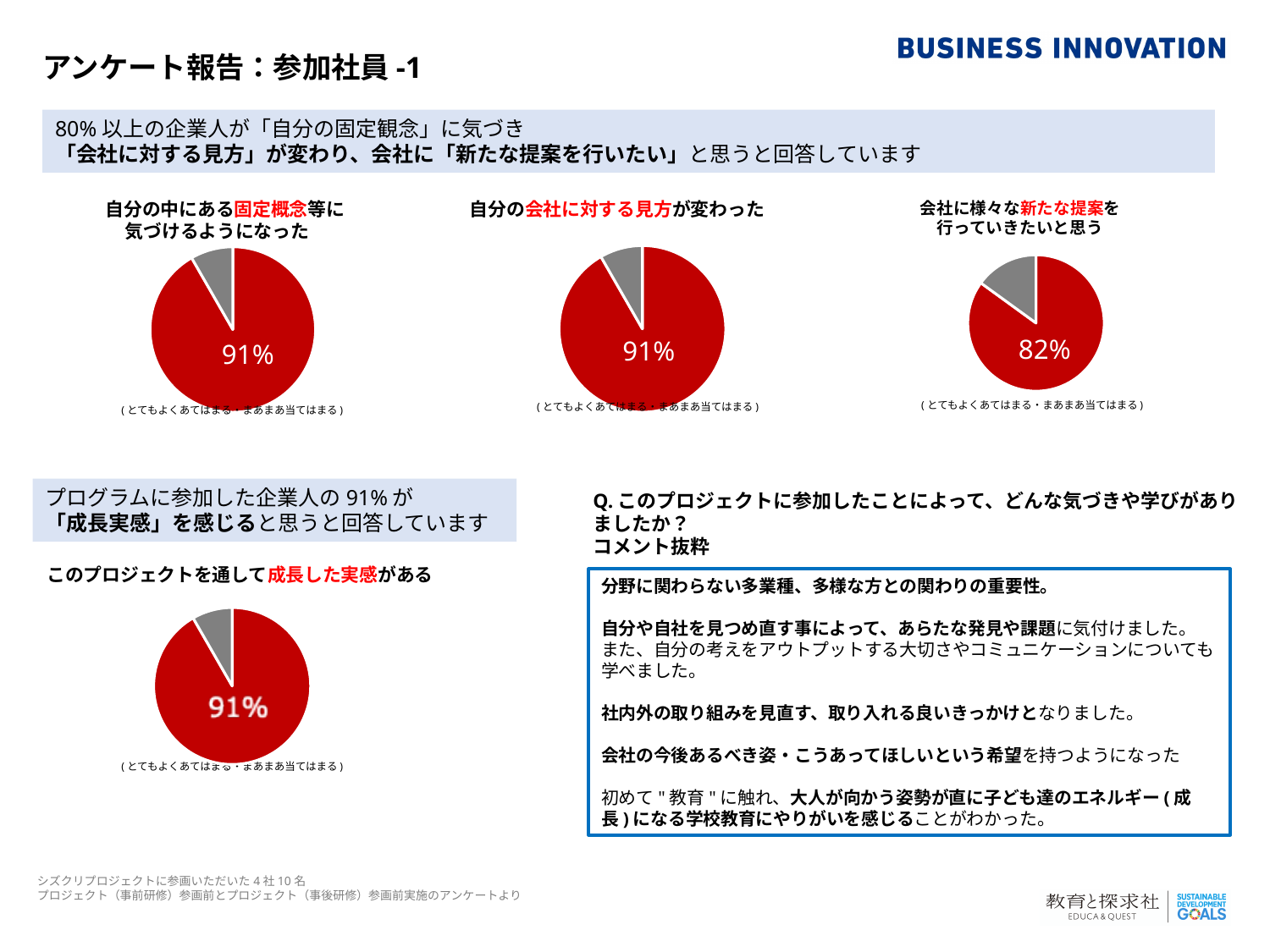
In the pie chart titled 「会社に様々な新たな提案を行っていきたいと思う」, what percentage is shown on the red slice? 82% How many pie charts are shown on the slide? 4 In the pie chart titled 「自分の中にある固定概念等に気づけるようになった」, what percentage is shown on the red slice? 91% In the pie chart titled 「会社に様々な新たな提案を行っていきたいと思う」, what colour is the slice labelled 82%? Red What is the difference between the percentage in the pie chart 「自分の中にある固定概念等に気づけるようになった」 and the percentage in the pie chart 「会社に様々な新たな提案を行っていきたいと思う」? 9% In the pie chart titled 「自分の会社に対する見方が変わった」, what percentage is shown on the red slice? 91% In the pie chart titled 「このプロジェクトを通して成長した実感がある」, what percentage is shown on the red slice? 91% In the pie chart titled 「自分の会社に対する見方が変わった」, is the percentage on the red slice greater or less than 90%? greater Which is larger: the percentage in the pie chart 「自分の会社に対する見方が変わった」 or the percentage in the pie chart 「会社に様々な新たな提案を行っていきたいと思う」? 自分の会社に対する見方が変わった What type of chart is used for 「このプロジェクトを通して成長した実感がある」? Pie chart How many slices does the pie chart titled 「会社に様々な新たな提案を行っていきたいと思う」 have? 2 Among the four pie charts on the slide, which one shows the lowest percentage? 会社に様々な新たな提案を行っていきたいと思う